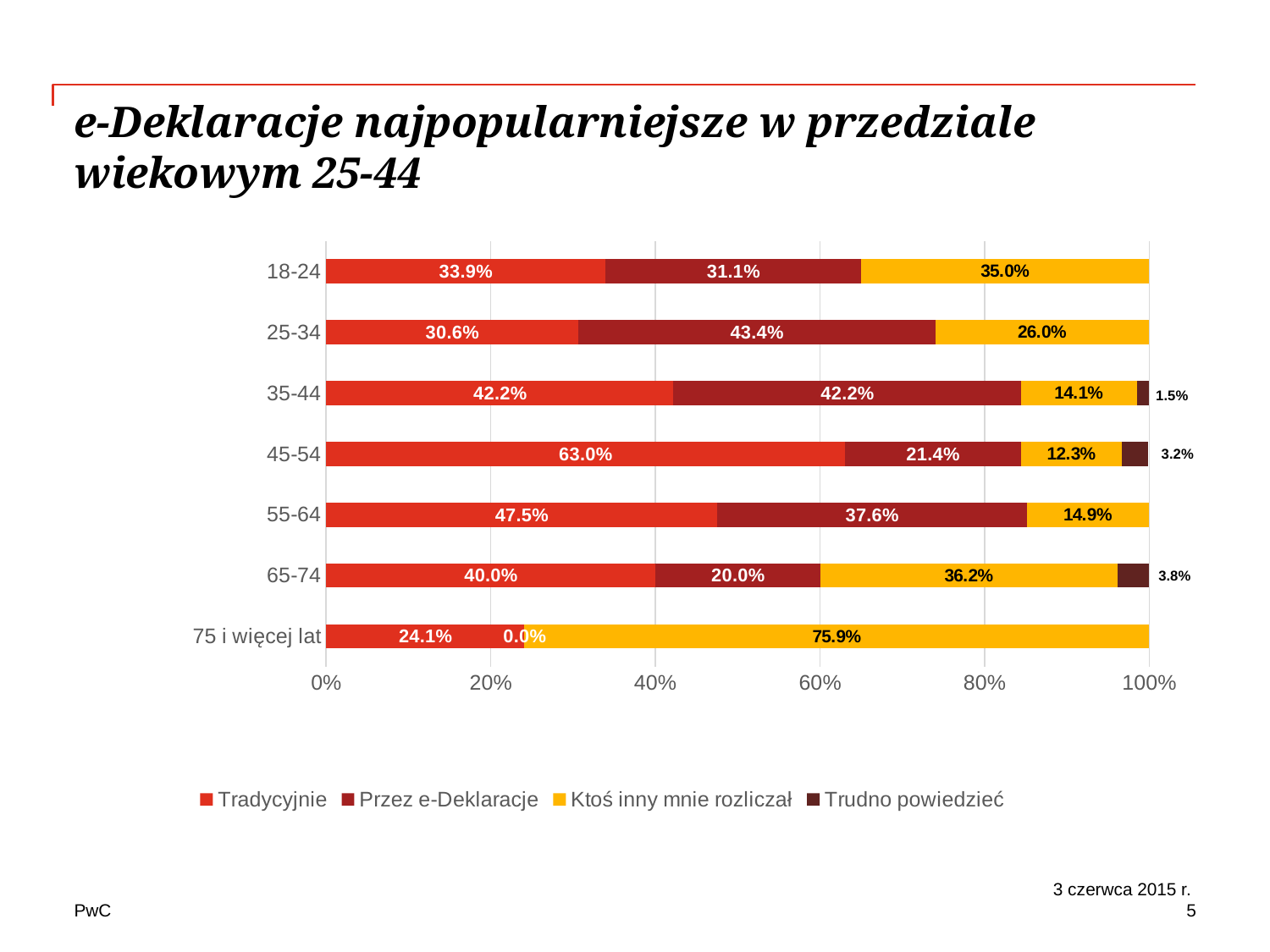
Which age group has the highest value for "Tradycyjnie"? 45-54 Which age group has the lowest value for "Przez e-Deklaracje"? 75 i więcej lat What is the value for "Przez e-Deklaracje" in the 25-34 age group? 43.4% What is the value for "Ktoś inny mnie rozliczał" in the "75 i więcej lat" group? 75.9% What kind of chart is shown on the slide? Stacked bar chart How many age groups are shown on the chart? 7 Which series is shown in yellow in the legend? Ktoś inny mnie rozliczał What is the difference between the "Tradycyjnie" values for the 45-54 and 55-64 age groups? 15.5% What is the value for "Trudno powiedzieć" in the 65-74 age group? 3.8% Which is larger: "Przez e-Deklaracje" for 18-24 or for 25-34? 25-34 What is the value for "Tradycyjnie" in the 45-54 age group? 63.0% How many series does the legend list? 4